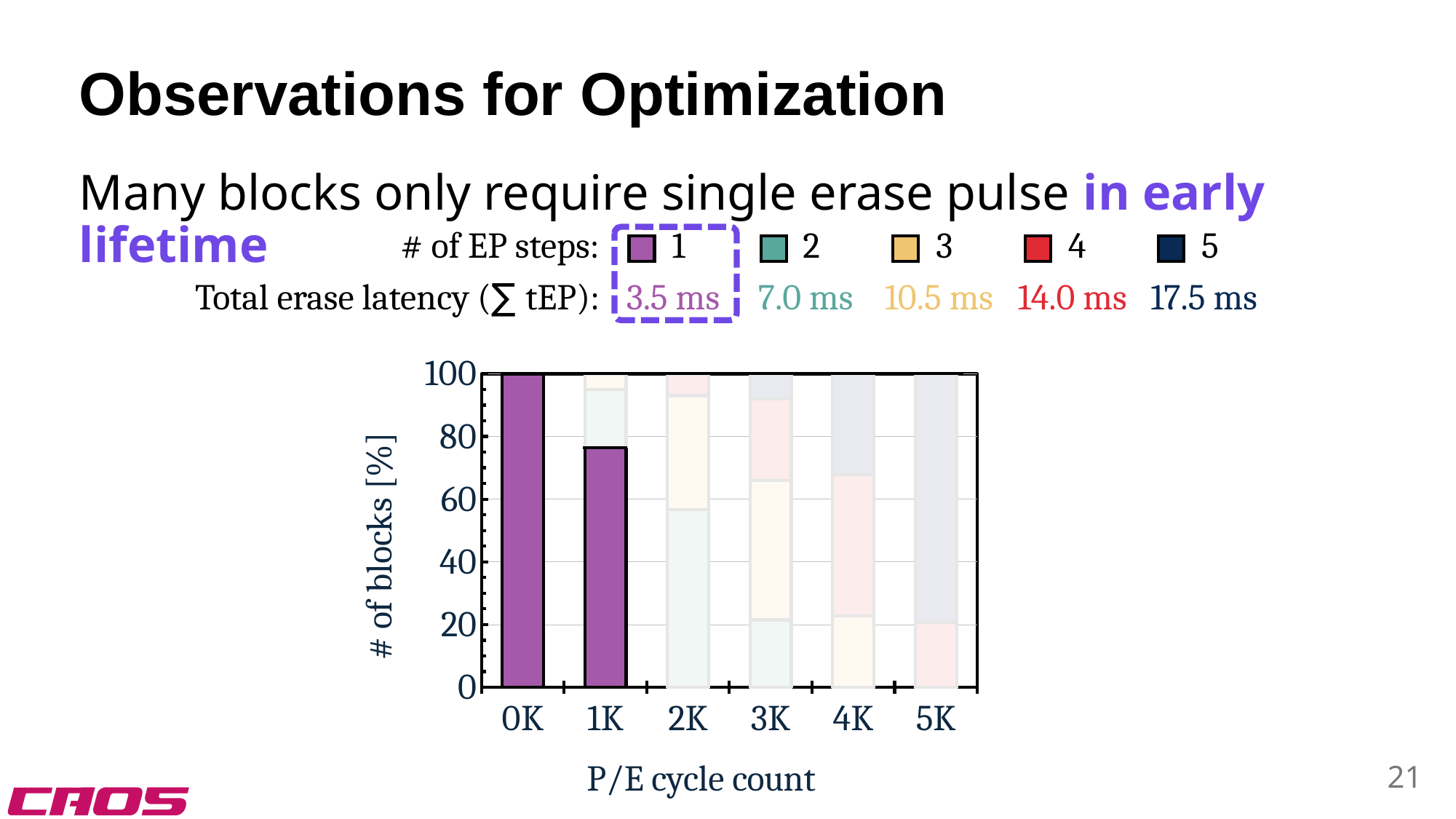
Is the percentage of blocks requiring 1 EP step at 1K greater or less than 80? less At which P/E cycle count is the share of blocks requiring 1 EP step highest? 0K How many P/E cycle count categories are shown on the x axis? 6 What is the label of the y axis? # of blocks [%] What percentage of blocks require 1 EP step at a P/E cycle count of 0K? 100 What kind of chart is shown on the slide? stacked bar chart Is the percentage of blocks requiring 1 EP step at 1K greater or less than 60? greater Does the share of blocks requiring 1 EP step rise or fall from 0K to 1K? fall Which has a larger share of blocks requiring 1 EP step, 0K or 1K? 0K How many series (# of EP steps) does the legend list? 5 Is the share of blocks requiring 2 EP steps at 2K greater or less than 40? greater What is the label of the x axis? P/E cycle count